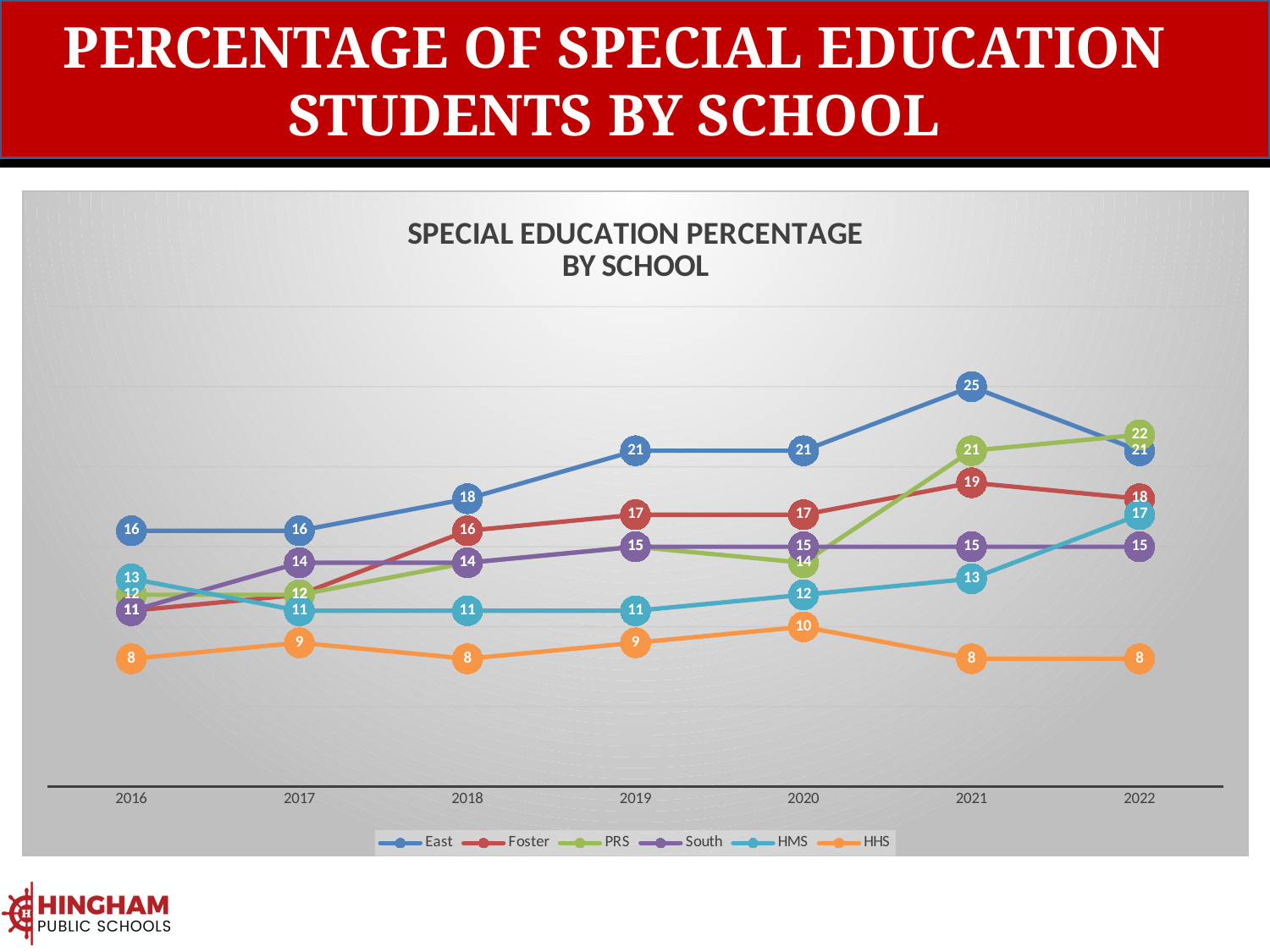
Which school has the lowest value in 2020? HHS What is the value for HHS in 2020? 10 Which is larger in 2022, the value for PRS or the value for Foster? PRS By how much did the PRS value increase from 2020 to 2021? 7 What is the value for HMS in 2022? 17 How many years are shown along the x axis? 7 What is the value for East in 2021? 25 How many series does the legend list? 6 Which school has the highest value in 2021? East Does the Foster line rise or fall from 2017 to 2021? rise What kind of chart is shown on the slide? line chart By how much did the East value drop from 2021 to 2022? 4